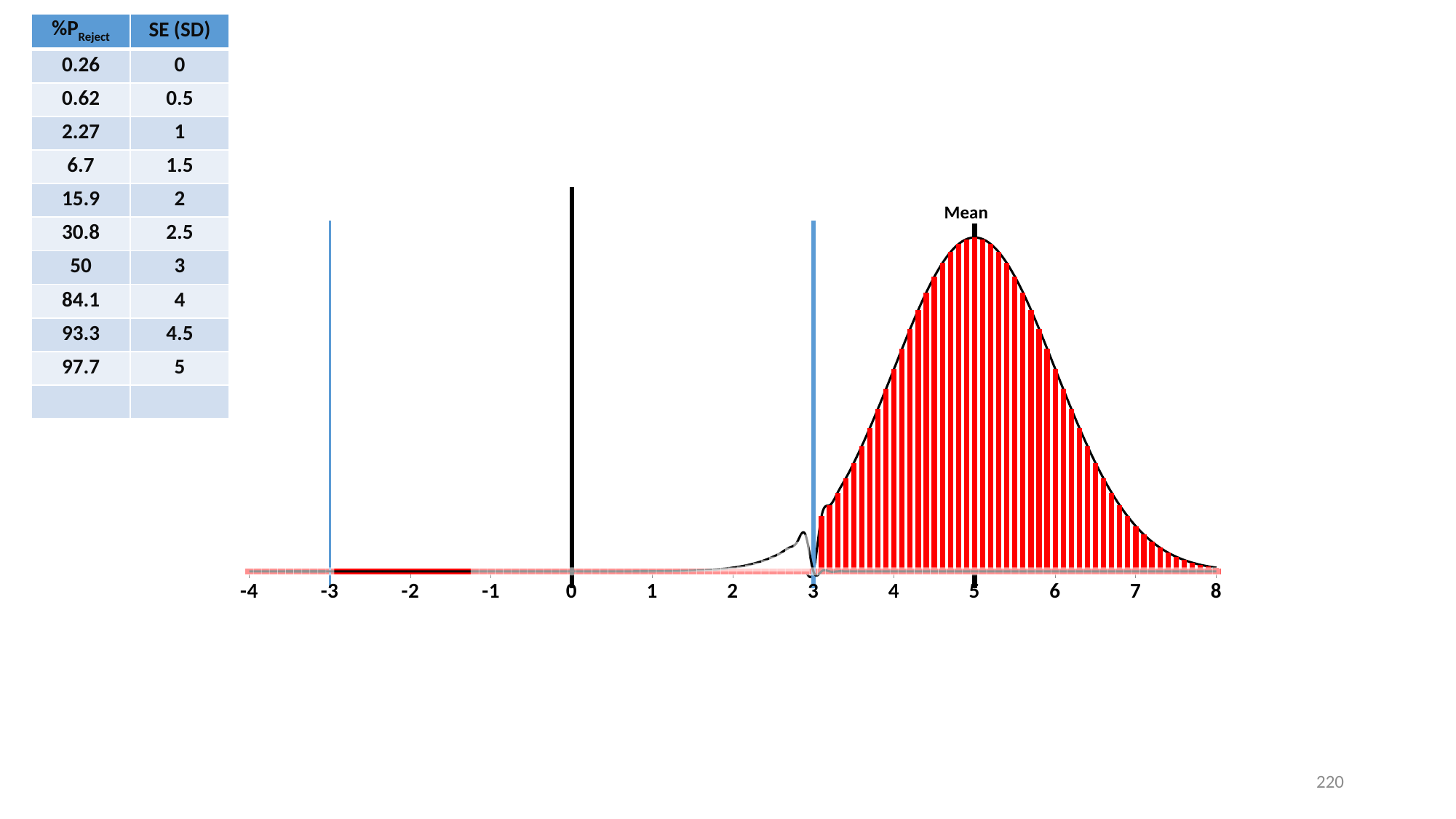
What is the lowest value labeled on the chart's x axis? -4 How many tick labels are shown on the chart's x axis? 13 Which is taller, the red bar at x = 5 or the red bar at x = 7? the bar at x = 5 Moving along the x axis from 3 to 5, do the red bars rise or fall in height? rise At which x-axis value is the tallest red bar located? 5 In the table, what SE (SD) value corresponds to a %P Reject of 97.7? 5 At which two x-axis values are the blue vertical lines drawn? -3 and 3 In the table, what is the %P Reject value when SE (SD) is 3? 50 Moving along the x axis from 5 to 8, do the red bars rise or fall in height? fall At which x-axis value is the label "Mean" placed on the chart? 5 What is the highest value labeled on the chart's x axis? 8 At which x-axis value is the tall black vertical line drawn? 0